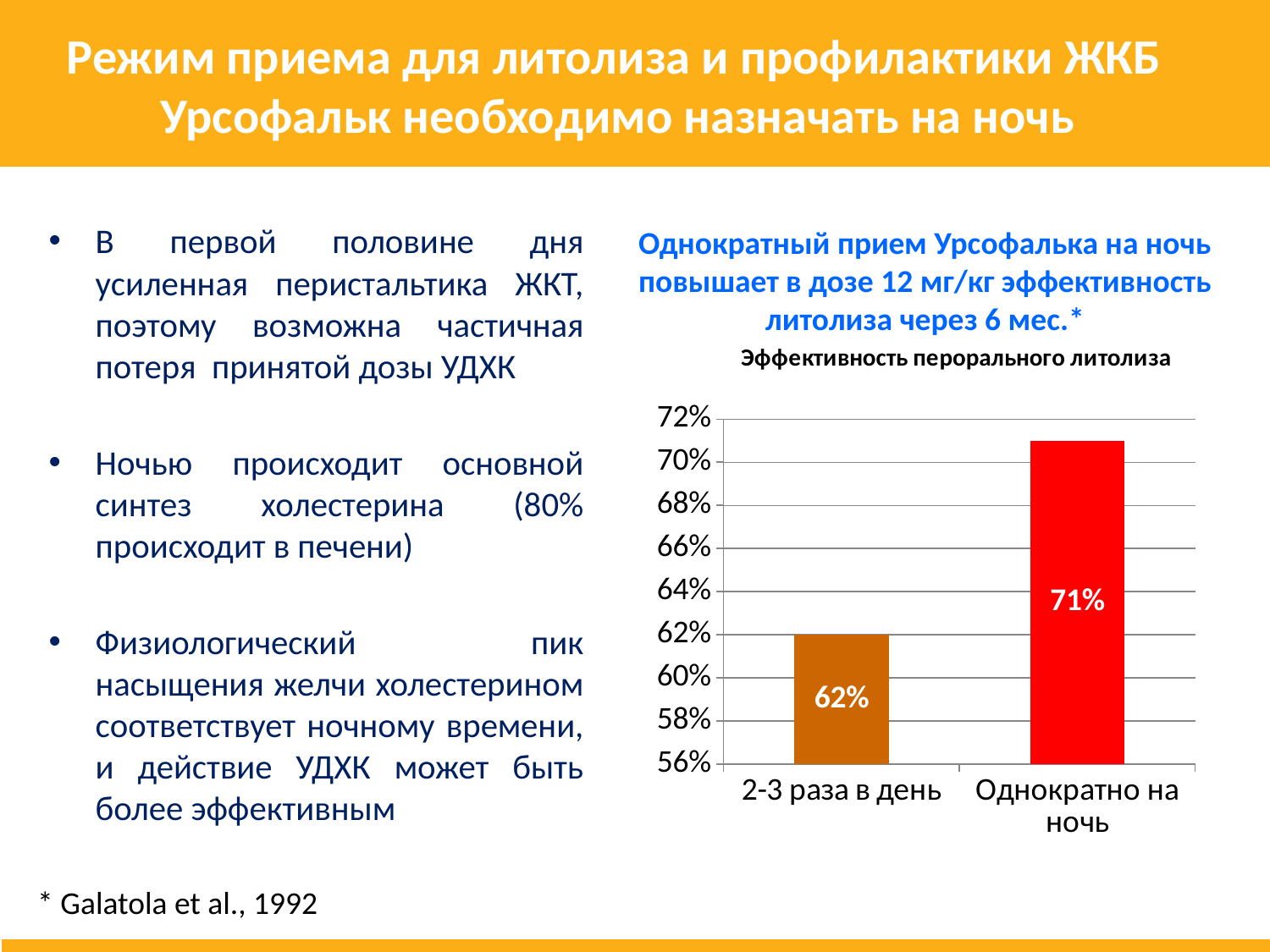
How many categories are shown on the chart? 2 Which is larger: the value for "2-3 раза в день" or for "Однократно на ночь"? Однократно на ночь Is the value for "Однократно на ночь" greater or less than 70%? greater What is the value for "Однократно на ночь"? 71% What is the difference between the values for "Однократно на ночь" and "2-3 раза в день"? 9% Which category has the highest value? Однократно на ночь What is the value for "2-3 раза в день"? 62% Which category has the lowest value? 2-3 раза в день Is the value for "2-3 раза в день" greater or less than 64%? less What colour is the bar for "Однократно на ночь"? red What kind of chart is shown on the slide? bar chart What is the title of the chart? Эффективность перорального литолиза